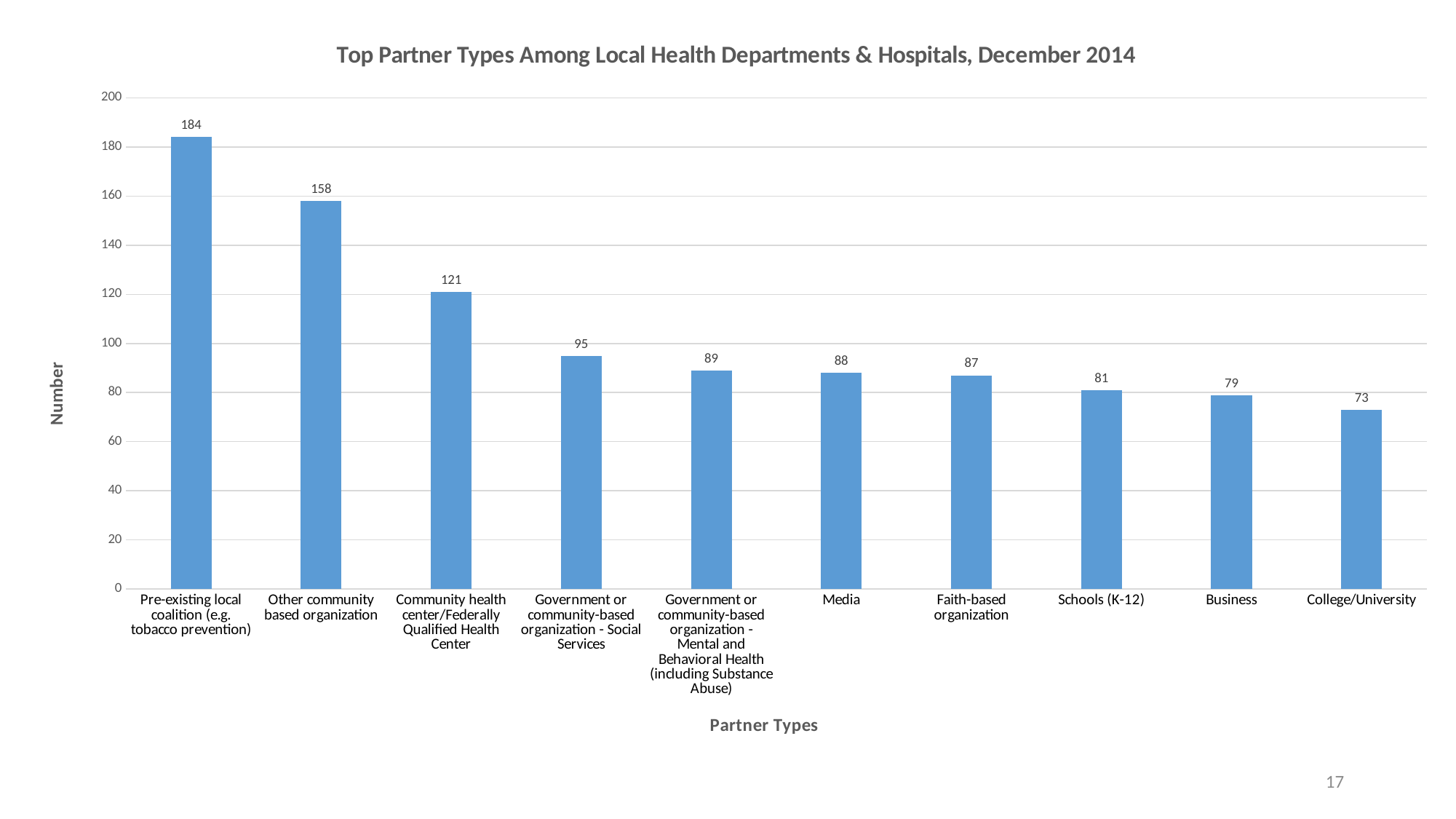
How many partner types are shown on the chart? 10 What is the value for Community health center/Federally Qualified Health Center? 121 What is the value for Media? 88 Is the value for Government or community-based organization - Social Services greater or less than 100? less What is the value for Schools (K-12)? 81 Which is larger, the value for Faith-based organization or the value for Schools (K-12)? Faith-based organization What is the title of the chart? Top Partner Types Among Local Health Departments & Hospitals, December 2014 Which partner type has the lowest value? College/University What kind of chart is shown on the slide? bar chart Which partner type has the highest value? Pre-existing local coalition (e.g. tobacco prevention) What is the difference between the values for Pre-existing local coalition (e.g. tobacco prevention) and Other community based organization? 26 What is the difference between the values for Business and College/University? 6